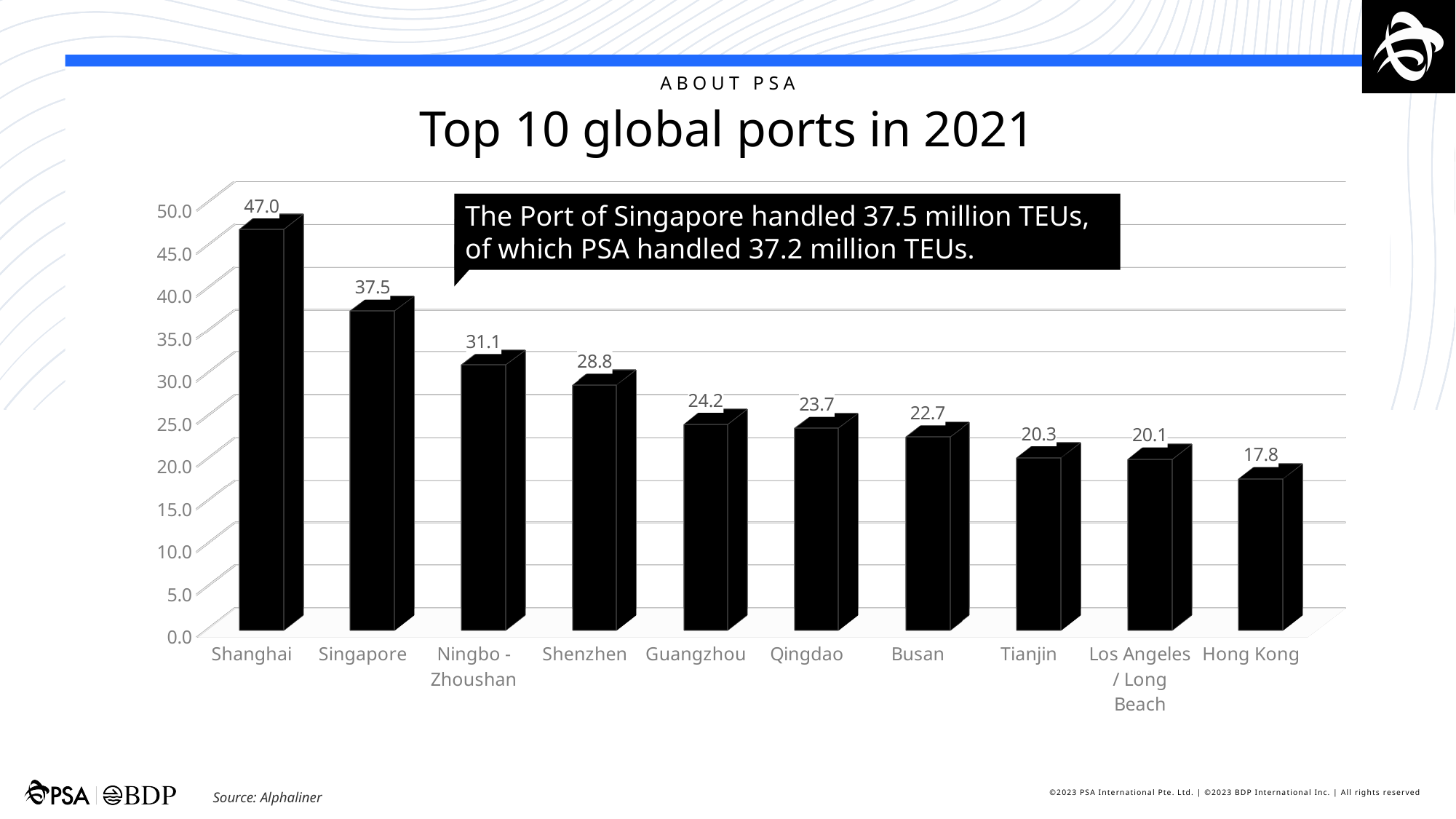
Which is larger, the value for Shenzhen or the value for Guangzhou? Shenzhen What is the value for Singapore? 37.5 Which port has the lowest value? Hong Kong What is the value for Ningbo - Zhoushan? 31.1 Which port has the highest value? Shanghai What kind of chart is shown on the slide? Bar chart What is the title of the chart? Top 10 global ports in 2021 What is the value for Shanghai? 47.0 What is the value for Hong Kong? 17.8 How many ports are shown in the chart? 10 Do the values rise or fall from left to right along the x axis? Fall What is the difference between the values for Shanghai and Singapore? 9.5